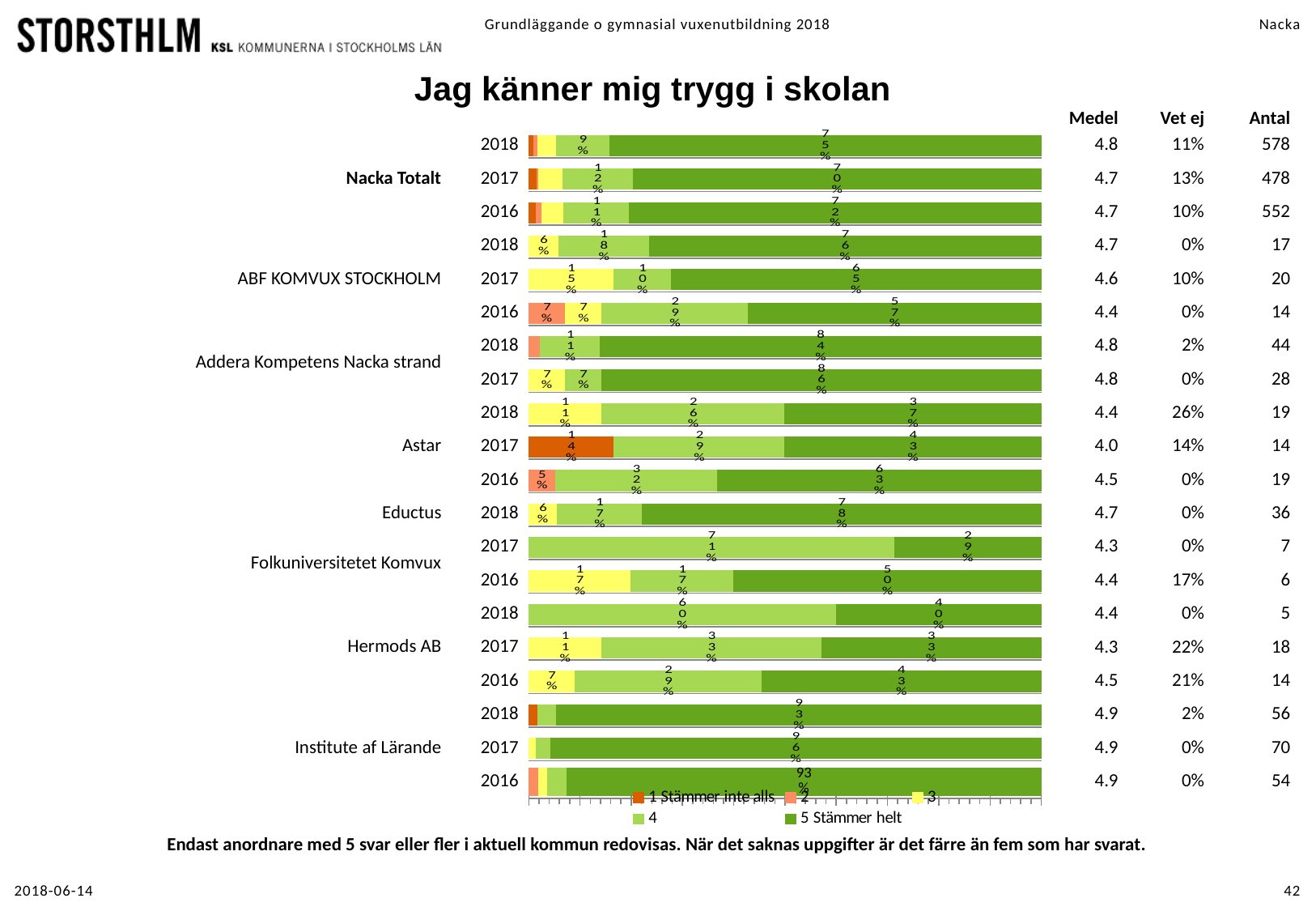
How many bars are plotted in the chart? 20 What is the value of '5 Stämmer helt' for Nacka Totalt in 2018? 75% How many series does the chart legend list? 5 What kind of chart is shown on the slide? bar chart What is the value of '1 Stämmer inte alls' for Astar in 2017? 14% What is the value of series '4' for Hermods AB in 2018? 60% What is the value of '5 Stämmer helt' for Addera Kompetens Nacka strand in 2018? 84% For Nacka Totalt, how much larger is the '5 Stämmer helt' share in 2018 than in 2017? 5 percentage points What is the value of '5 Stämmer helt' for Eductus in 2018? 78% What is the value of series '4' for Folkuniversitetet Komvux in 2017? 71% For Nacka Totalt, which year has the larger '5 Stämmer helt' share, 2018 or 2017? 2018 What is the value of '5 Stämmer helt' for Institute af Lärande in 2016? 93%